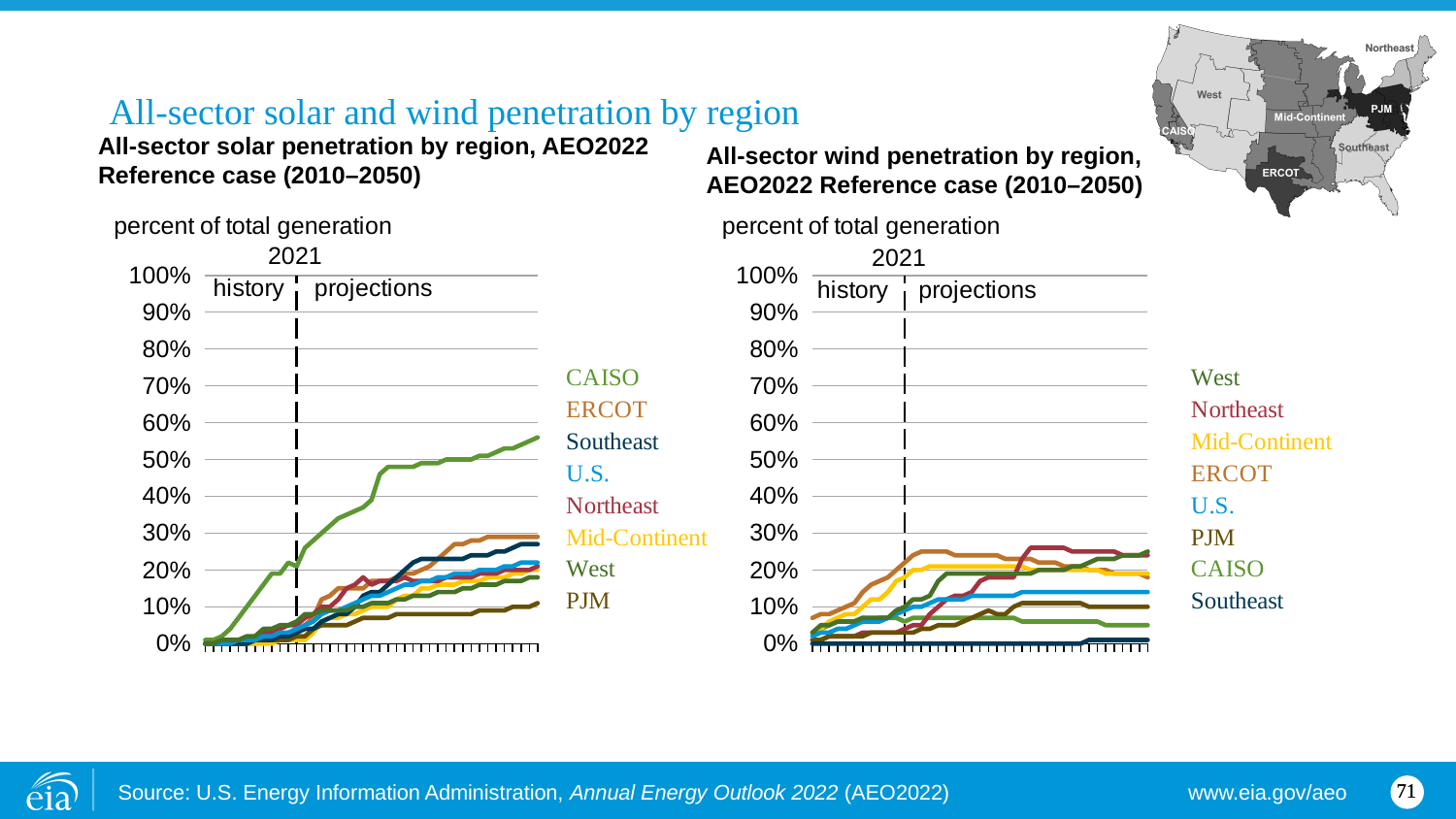
What year does the dashed vertical line separating history from projections mark on the charts? 2021 How many series does the legend of the 'All-sector solar penetration by region' chart list? 8 In the 'All-sector solar penetration by region' chart, is the value for PJM at the end of the projection period greater or less than 20%? less What kind of chart is the 'All-sector solar penetration by region' chart? line chart In the 'All-sector wind penetration by region' chart, which region has the lowest wind penetration at the end of the projection period? Southeast In the 'All-sector solar penetration by region' chart, which region has the lowest solar penetration at the end of the projection period? PJM How many series does the legend of the 'All-sector wind penetration by region' chart list? 8 In the 'All-sector solar penetration by region' chart, does the CAISO line rise or fall over the period shown? rise In the 'All-sector wind penetration by region' chart, which is larger at the end of the projection period, West or Southeast? West In the 'All-sector wind penetration by region' chart, is the value for Southeast at the end of the projection period greater or less than 10%? less In the 'All-sector solar penetration by region' chart, is the value for CAISO at the end of the projection period greater or less than 50%? greater In the 'All-sector solar penetration by region' chart, which region has the highest solar penetration at the end of the projection period? CAISO